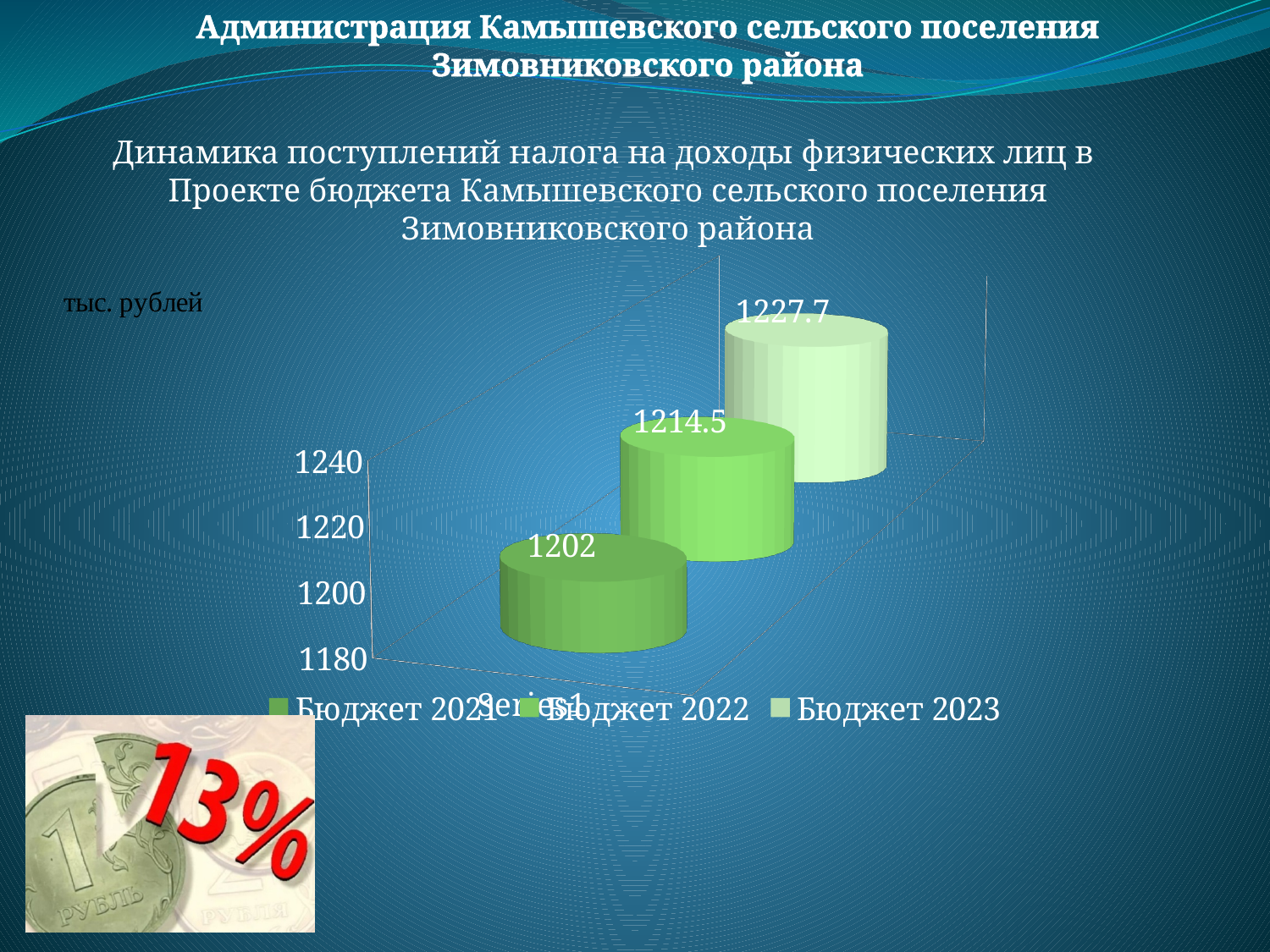
In what units are the values on the chart expressed? тыс. рублей How many series does the legend list? 3 What is the difference between the values for Бюджет 2023 and Бюджет 2021? 25.7 What is the value for Бюджет 2022? 1214.5 What kind of chart is shown on the slide? bar chart What is the value for Бюджет 2023? 1227.7 Which is larger, the value for Бюджет 2022 or Бюджет 2023? Бюджет 2023 What is the difference between the values for Бюджет 2022 and Бюджет 2021? 12.5 Which series has the highest value? Бюджет 2023 Is the value for Бюджет 2021 greater or less than 1220? less Which series has the lowest value? Бюджет 2021 What is the value for Бюджет 2021? 1202